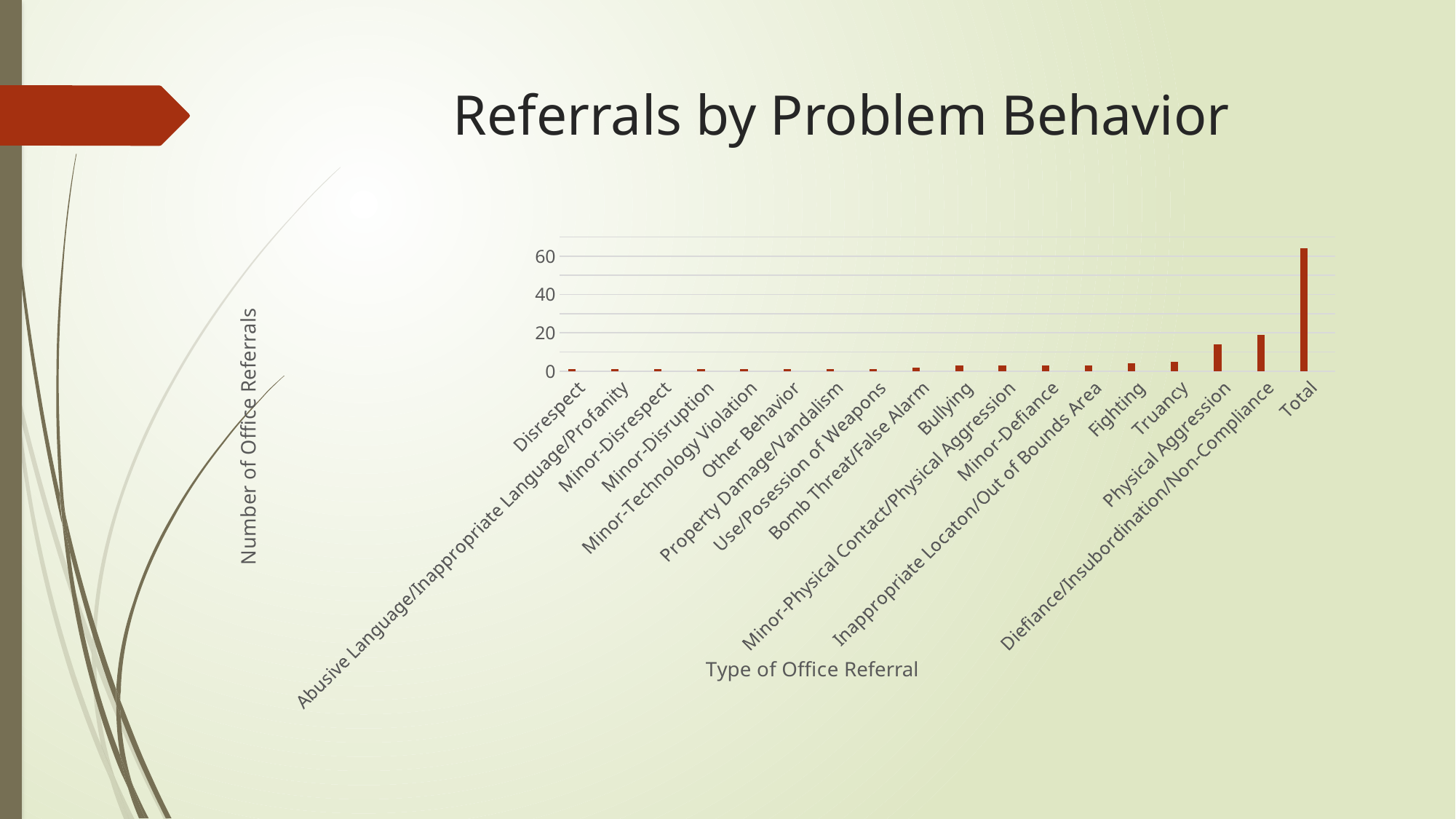
What is the label on the vertical axis of the chart? Number of Office Referrals Which has more office referrals, Diefiance/Insubordination/Non-Compliance or Fighting? Diefiance/Insubordination/Non-Compliance Which category has the tallest bar? Total Excluding the Total bar, which problem behavior has the highest number of office referrals? Diefiance/Insubordination/Non-Compliance Is the value for Total greater or less than 60? greater What is the title of the chart? Referrals by Problem Behavior How many categories are plotted along the x axis? 18 What kind of chart is shown on the slide? bar chart Do the bar values generally rise or fall moving from left to right along the x axis? rise Is the value for Physical Aggression greater or less than 20? less Which has more office referrals, Physical Aggression or Truancy? Physical Aggression